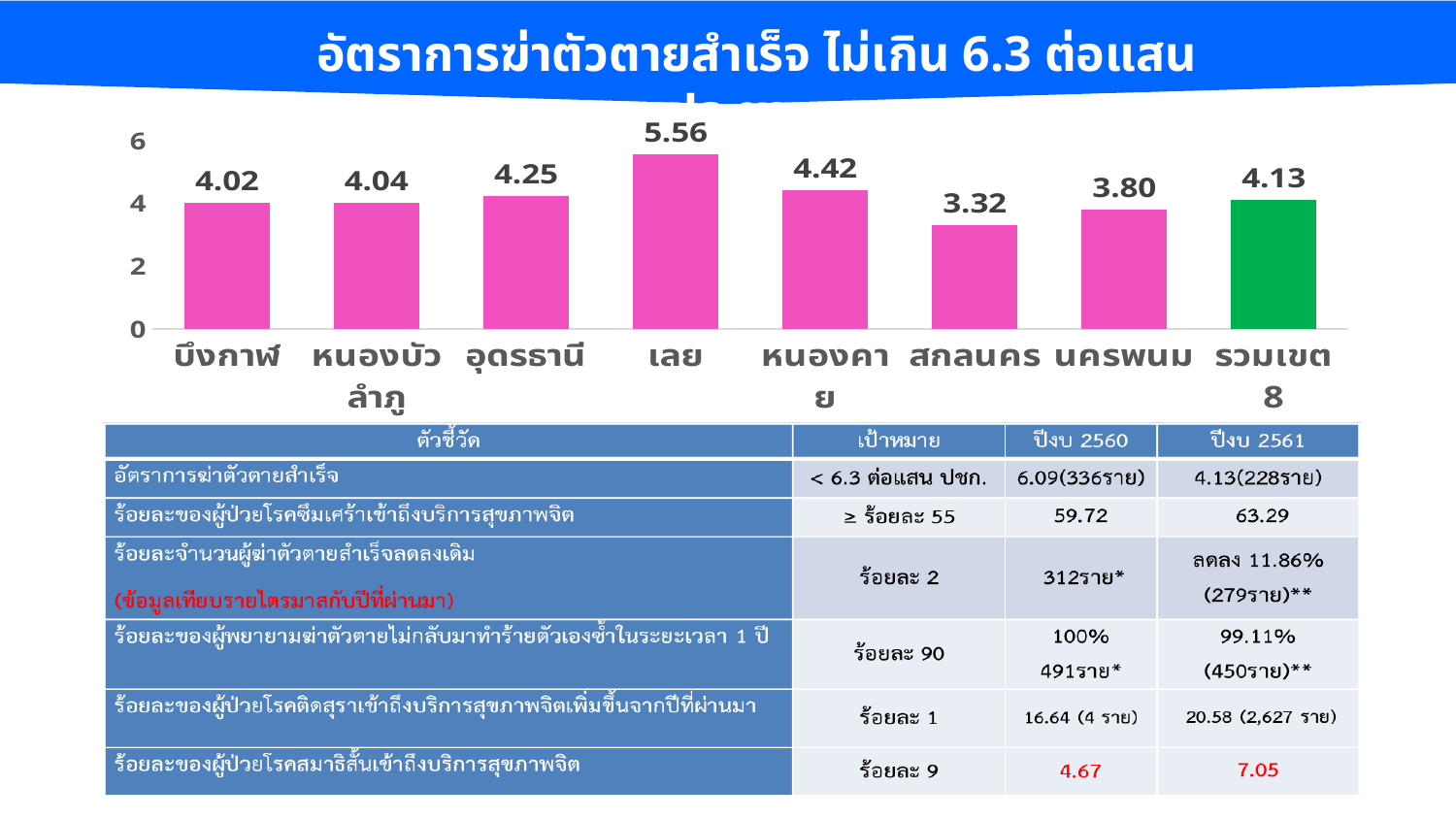
What is the difference between the values for เลย and สกลนคร? 2.24 What is the value for เลย in the bar chart? 5.56 Is the value for เลย greater or less than 4? greater Which is larger, the value for อุดรธานี or the value for นครพนม? อุดรธานี What is the value for หนองคาย in the bar chart? 4.42 How many categories are shown in the bar chart? 8 Which category has the lowest value in the bar chart? สกลนคร What is the value for รวมเขต 8 in the bar chart? 4.13 What kind of chart is shown on the slide? bar chart Which category has the highest value in the bar chart? เลย Which bar in the chart is coloured green rather than pink? รวมเขต 8 What is the value for สกลนคร in the bar chart? 3.32